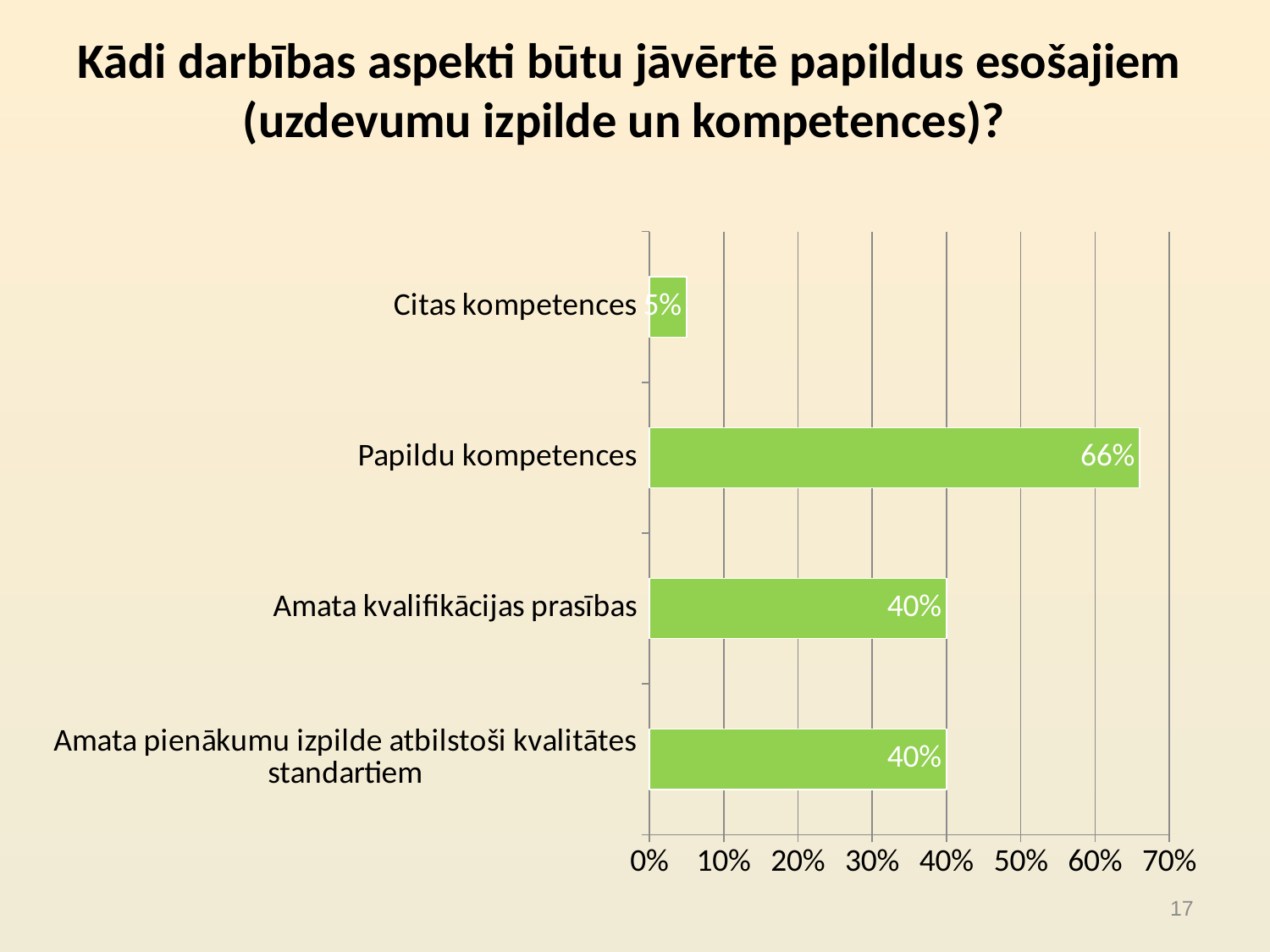
Is the value for Papildu kompetences greater or less than 60%? greater Which category has the highest value? Papildu kompetences What is the highest value shown on the horizontal axis? 70% What is the value for Papildu kompetences? 66% What is the value for Amata pienākumu izpilde atbilstoši kvalitātes standartiem? 40% Which category has the lowest value? Citas kompetences Which is larger, the value for Papildu kompetences or the value for Citas kompetences? Papildu kompetences How many categories does the chart show? 4 What is the value for Citas kompetences? 5% What is the value for Amata kvalifikācijas prasības? 40% What kind of chart is shown on the slide? bar chart What is the difference between the values for Papildu kompetences and Amata kvalifikācijas prasības? 26%